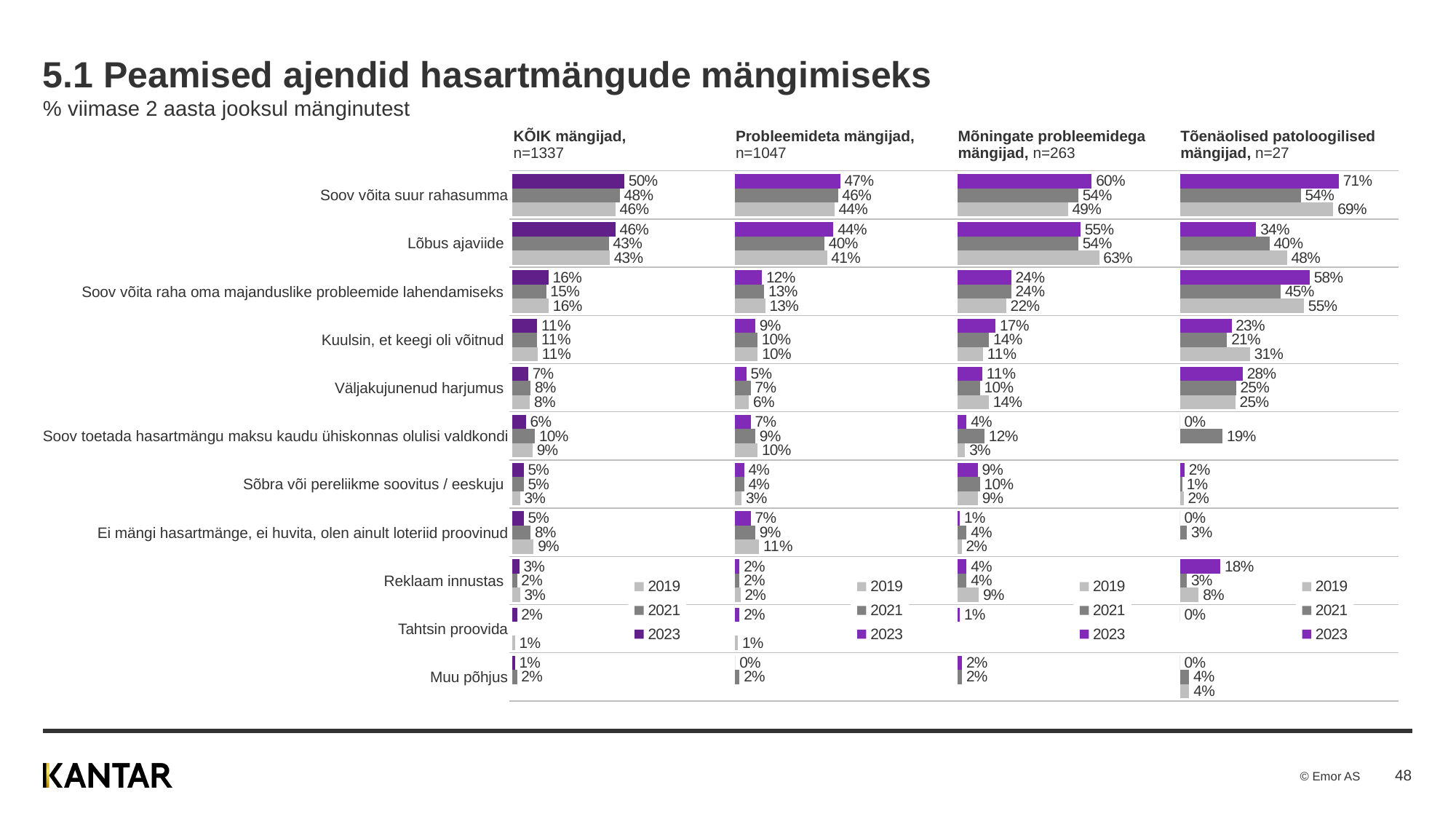
How many series does the legend list for each chart? 3 In the "Probleemideta mängijad" chart, which is larger for "Lõbus ajaviide": the 2023 value or the 2019 value? 2023 What kind of chart is used on this slide? Bar chart In the "KÕIK mängijad" chart, what is the 2023 value for "Soov võita suur rahasumma"? 50% In the "Tõenäolised patoloogilised mängijad" chart, what is the 2023 value for "Reklaam innustas"? 18% In the "Mõningate probleemidega mängijad" chart, what is the 2019 value for "Lõbus ajaviide"? 63% How many categories are shown in the "KÕIK mängijad" chart? 11 In the "Mõningate probleemidega mängijad" chart, which category has the highest 2023 value? Soov võita suur rahasumma In the "Tõenäolised patoloogilised mängijad" chart, what is the 2019 value for "Soov võita suur rahasumma"? 69% In the "KÕIK mängijad" chart, which category has the lowest 2023 value? Muu põhjus In the "Tõenäolised patoloogilised mängijad" chart, what is the difference between the 2023 and 2021 values for "Soov võita raha oma majanduslike probleemide lahendamiseks"? 13 percentage points In the "KÕIK mängijad" chart, did the value for "Soov võita suur rahasumma" rise or fall from 2019 to 2023? Rise